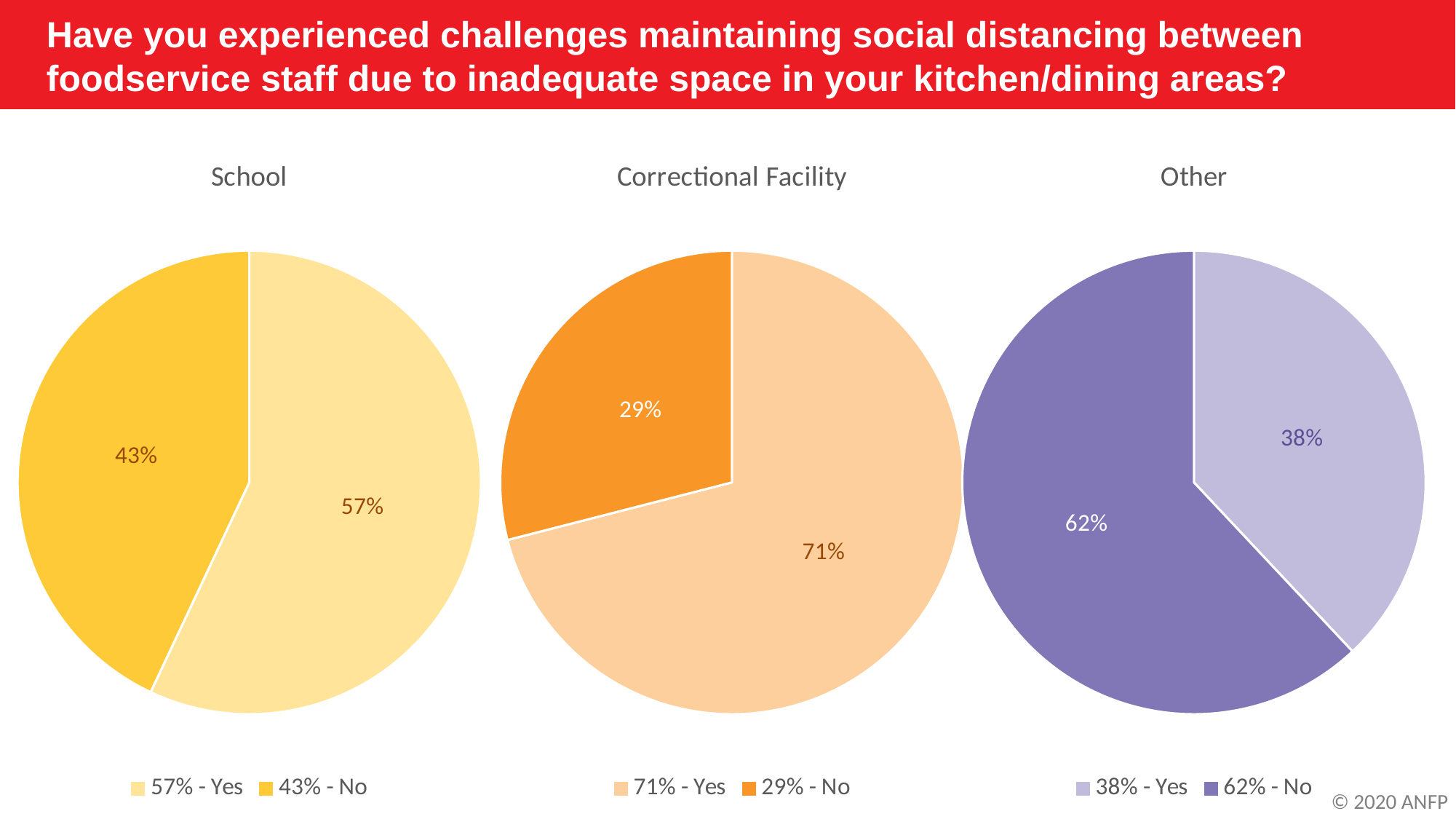
In the School chart, what share of respondents answered Yes? 57% How many entries does the legend of the School chart list? 2 In the Correctional Facility chart, what share of respondents answered No? 29% Is the Yes share larger in the School chart or in the Correctional Facility chart? Correctional Facility In the Correctional Facility chart, what is the difference between the Yes and No shares? 42% How many pie charts are on the slide? 3 In the Other chart, what share of respondents answered Yes? 38% In the Correctional Facility chart, which response has the larger slice? Yes In the Other chart, which response has the smaller slice? Yes What kind of chart is used on this slide? Pie chart In the School chart, what is the difference between the Yes and No shares? 14% In the Other chart, what share of respondents answered No? 62%